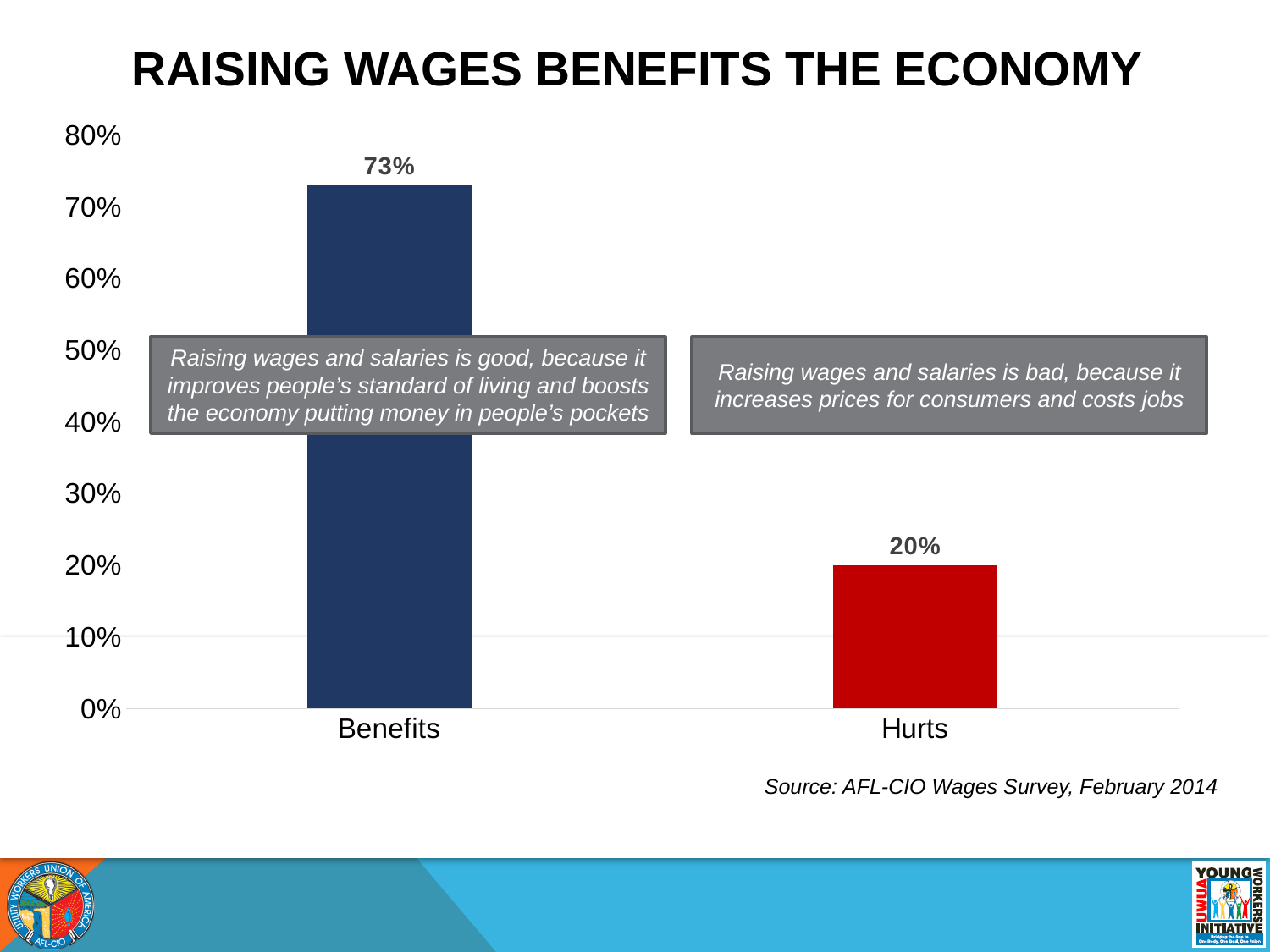
Which is larger, the value for Benefits or the value for Hurts? Benefits What is the value for Benefits? 73% Which category has the lowest value? Hurts What is the difference between the values for Benefits and Hurts? 53% What kind of chart is shown on the slide? bar chart How many categories are shown on the x axis? 2 Which category has the highest value? Benefits What is the title of the slide? RAISING WAGES BENEFITS THE ECONOMY What colour is the bar for Hurts? red Is the value for Hurts greater or less than 30%? less Is the value for Benefits greater or less than 70%? greater What is the value for Hurts? 20%